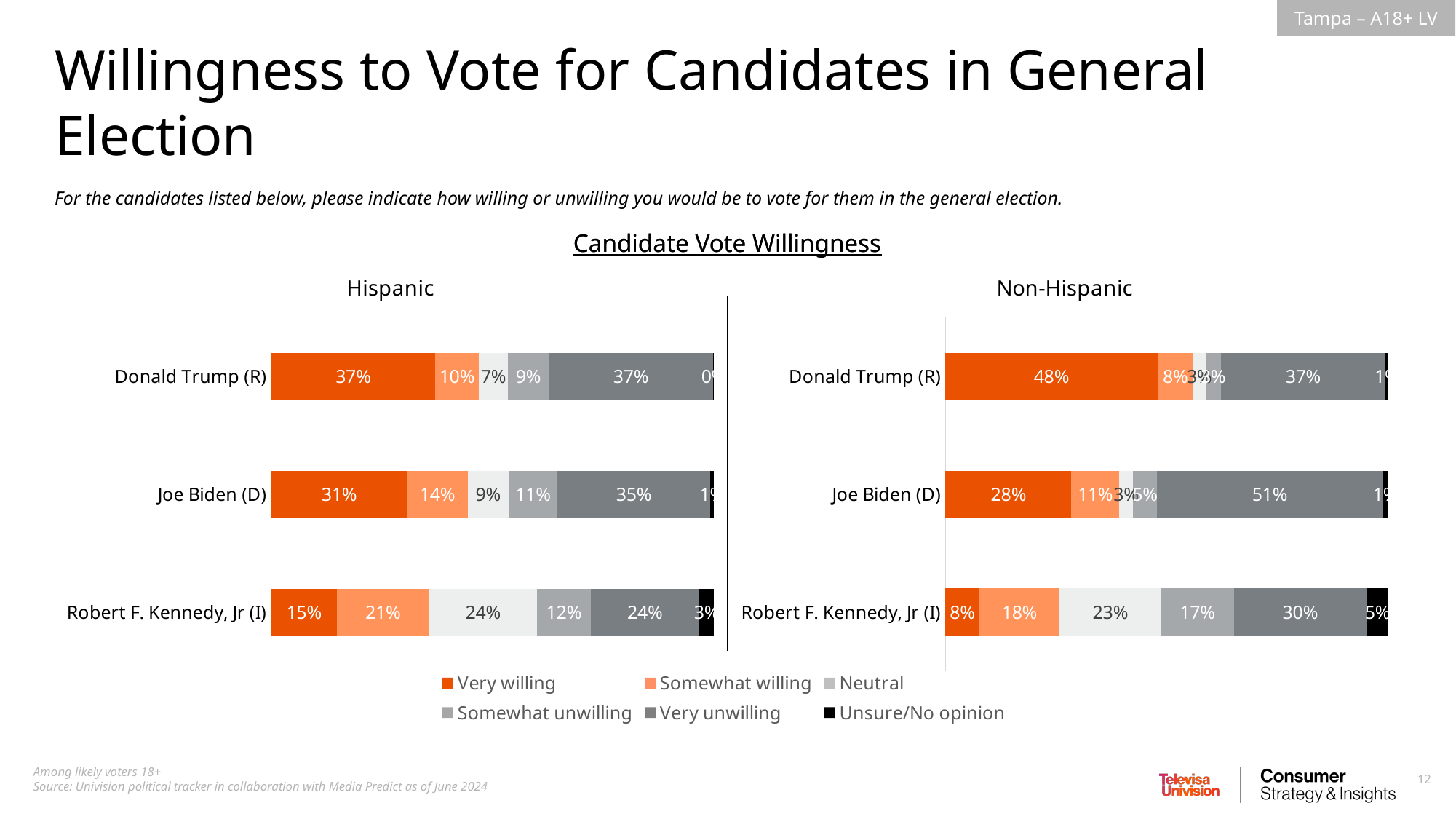
How many candidates are shown in the Hispanic chart? 3 In the Non-Hispanic chart, what percentage of respondents are unsure/no opinion about voting for Robert F. Kennedy, Jr (I)? 5% In the Non-Hispanic chart, what percentage of respondents are very willing to vote for Donald Trump (R)? 48% In the Non-Hispanic chart, which candidate has the lowest share of very willing respondents? Robert F. Kennedy, Jr (I) In the Hispanic chart, what percentage of respondents are very willing to vote for Donald Trump (R)? 37% What kind of chart is used to show candidate vote willingness? Stacked bar chart In the Non-Hispanic chart, what percentage of respondents are very unwilling to vote for Joe Biden (D)? 51% In the Hispanic chart, which candidate has the highest share of very willing respondents? Donald Trump (R) In the Hispanic chart, what percentage of respondents are neutral about voting for Robert F. Kennedy, Jr (I)? 24% In the Hispanic chart, what is the difference in percentage points between the very willing share for Donald Trump (R) and for Joe Biden (D)? 6 percentage points How many series does the legend list? 6 In the Non-Hispanic chart, which candidate has the larger very unwilling share, Joe Biden (D) or Donald Trump (R)? Joe Biden (D)